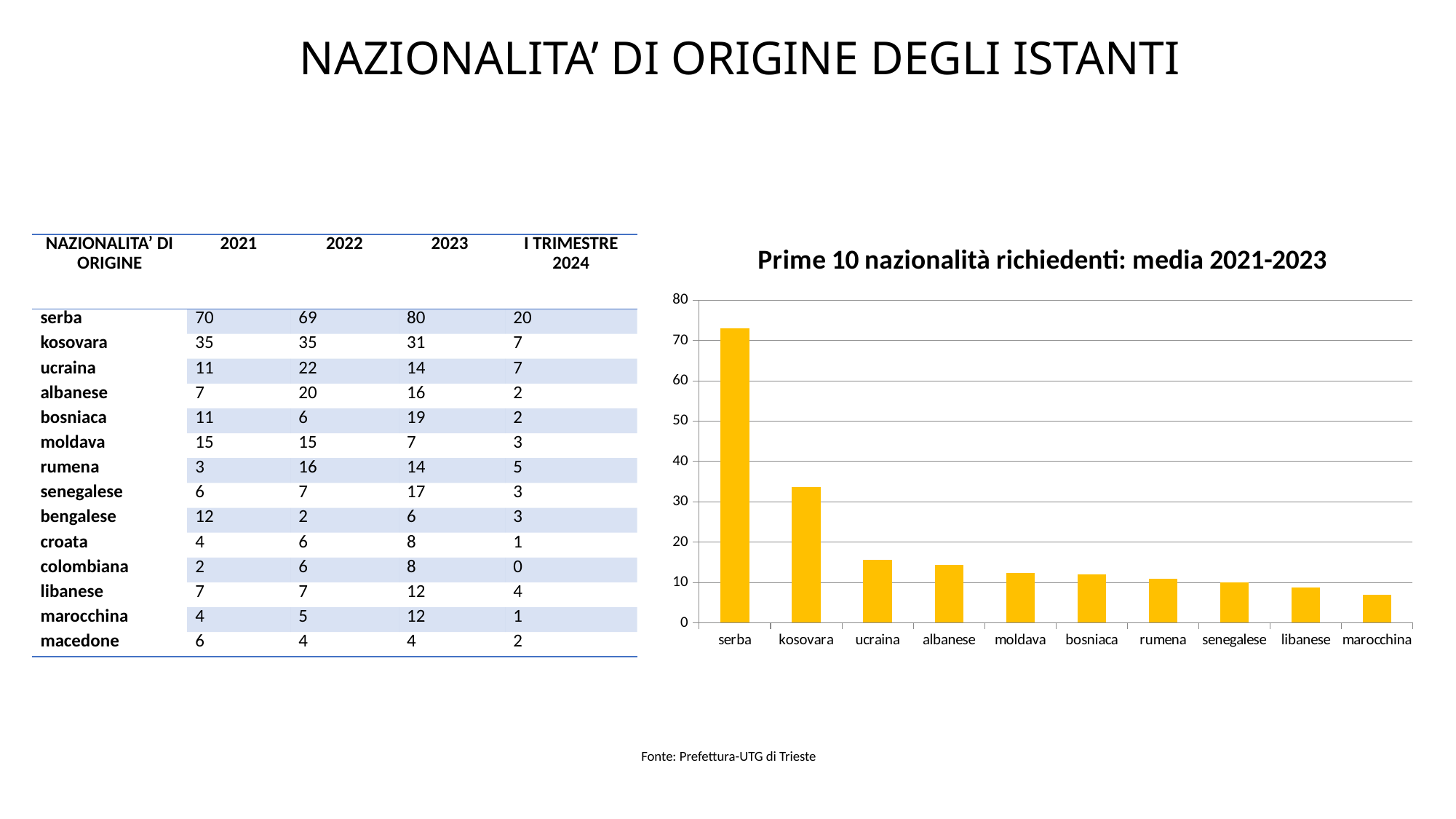
Which nationality has the highest bar in the chart? serba What colour are the bars in the chart? yellow Is the value for marocchina greater or less than 10? less Is the value for ucraina greater or less than 20? less Do the bar values rise or fall from left to right along the x axis? fall Which nationality has the lowest bar in the chart? marocchina What is the title of the chart? Prime 10 nazionalità richiedenti: media 2021-2023 How many nationalities are shown in the chart? 10 Is the value for serba greater or less than 70? greater What kind of chart is shown on the slide? bar chart Which is larger in the chart, the value for kosovara or the value for albanese? kosovara